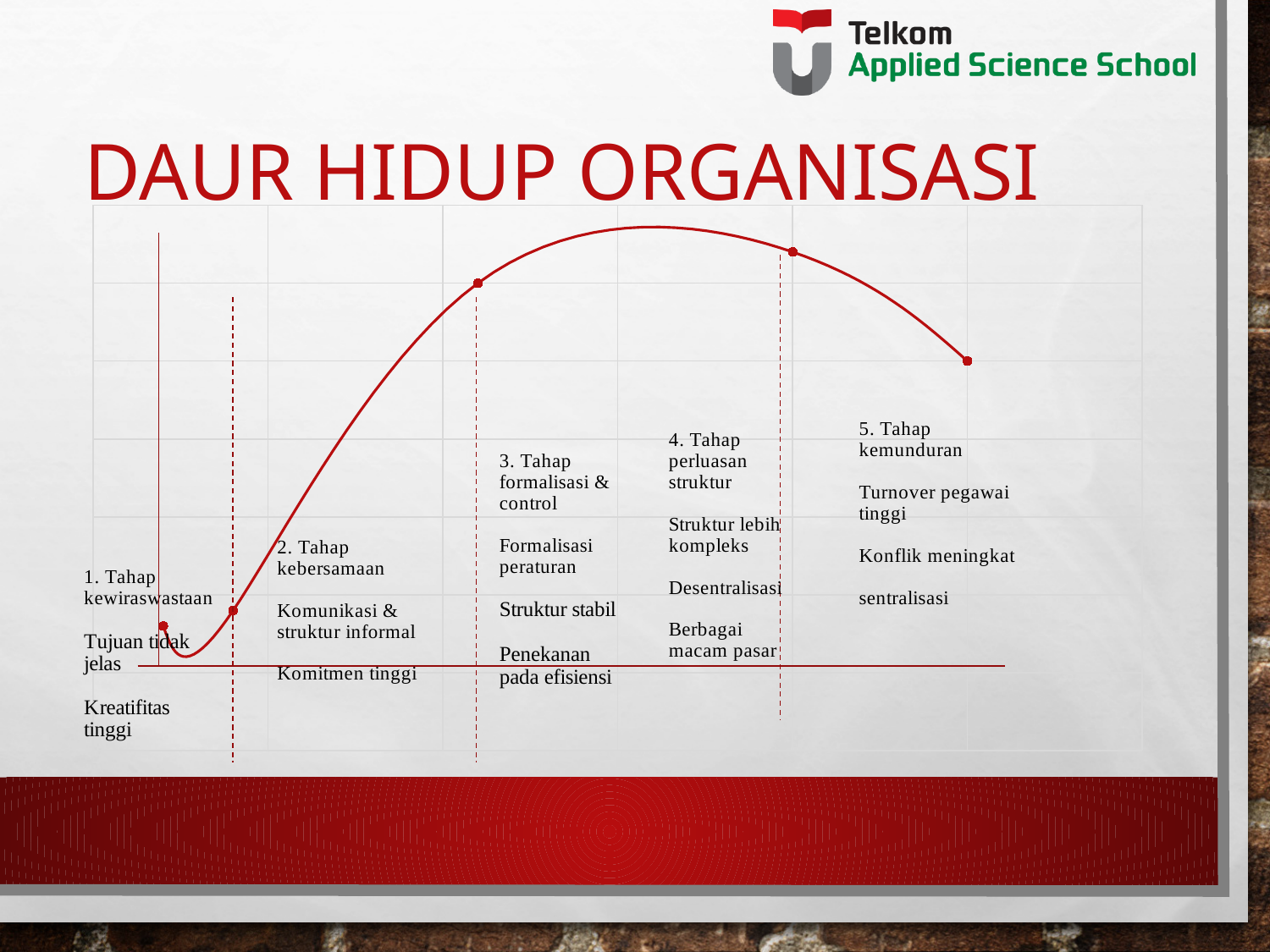
Does the curve rise or fall from stage 1 (Tahap kewiraswastaan) to stage 3 (Tahap formalisasi & control)? rise Is the curve higher at the start of stage 1 or at the end of stage 5? end of stage 5 Is the curve higher at the end of stage 2 (Tahap kebersamaan) or at the end of stage 5 (Tahap kemunduran)? end of stage 2 (Tahap kebersamaan) Does the curve rise or fall during stage 5 (Tahap kemunduran)? fall Which stage contains the lowest point of the curve? 1. Tahap kewiraswastaan Which stage is labeled with 'Turnover pegawai tinggi'? 5. Tahap kemunduran How many marker points are plotted on the curve? 5 Which stage contains the highest point of the curve? 4. Tahap perluasan struktur How many stages (tahap) are labeled along the curve? 5 What kind of chart is shown on the slide? line chart What is the title of the slide containing the chart? DAUR HIDUP ORGANISASI